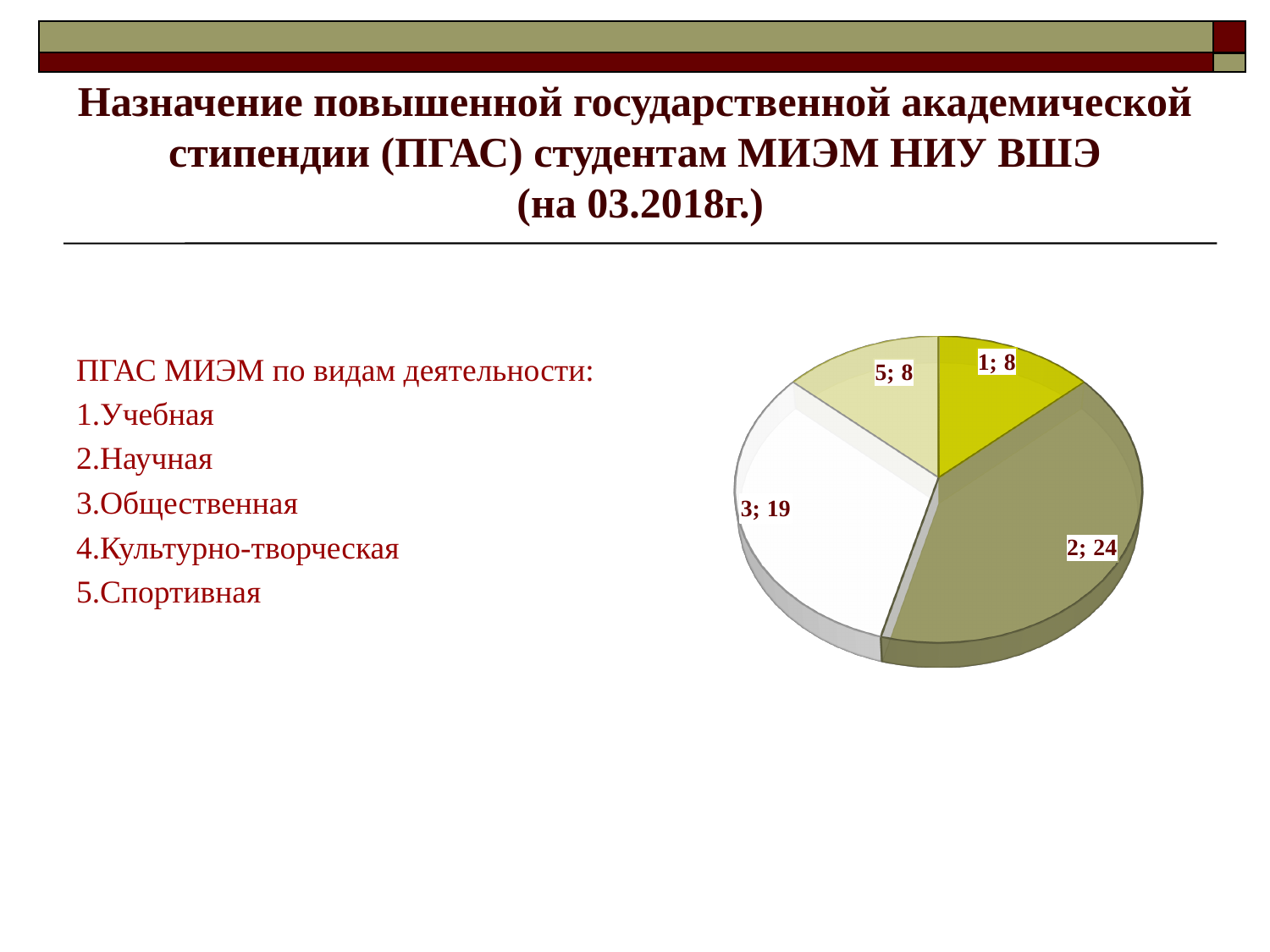
Which is larger in the pie chart, slice 2 or slice 3? slice 2 According to the list on the slide, which type of activity does slice 2 of the pie chart correspond to? Научная What value is shown for slice 5 in the pie chart? 8 What value is shown for slice 3 in the pie chart? 19 How many slices are labelled in the pie chart? 4 What is the difference between the values of slice 3 and slice 5 in the pie chart? 11 What kind of chart is shown on the slide? pie chart Which slice of the pie chart has the largest value? 2 What value is shown for slice 1 in the pie chart? 8 What value is shown for slice 2 in the pie chart? 24 What is the total of all the labelled slice values in the pie chart? 59 What is the difference between the values of slice 2 and slice 3 in the pie chart? 5